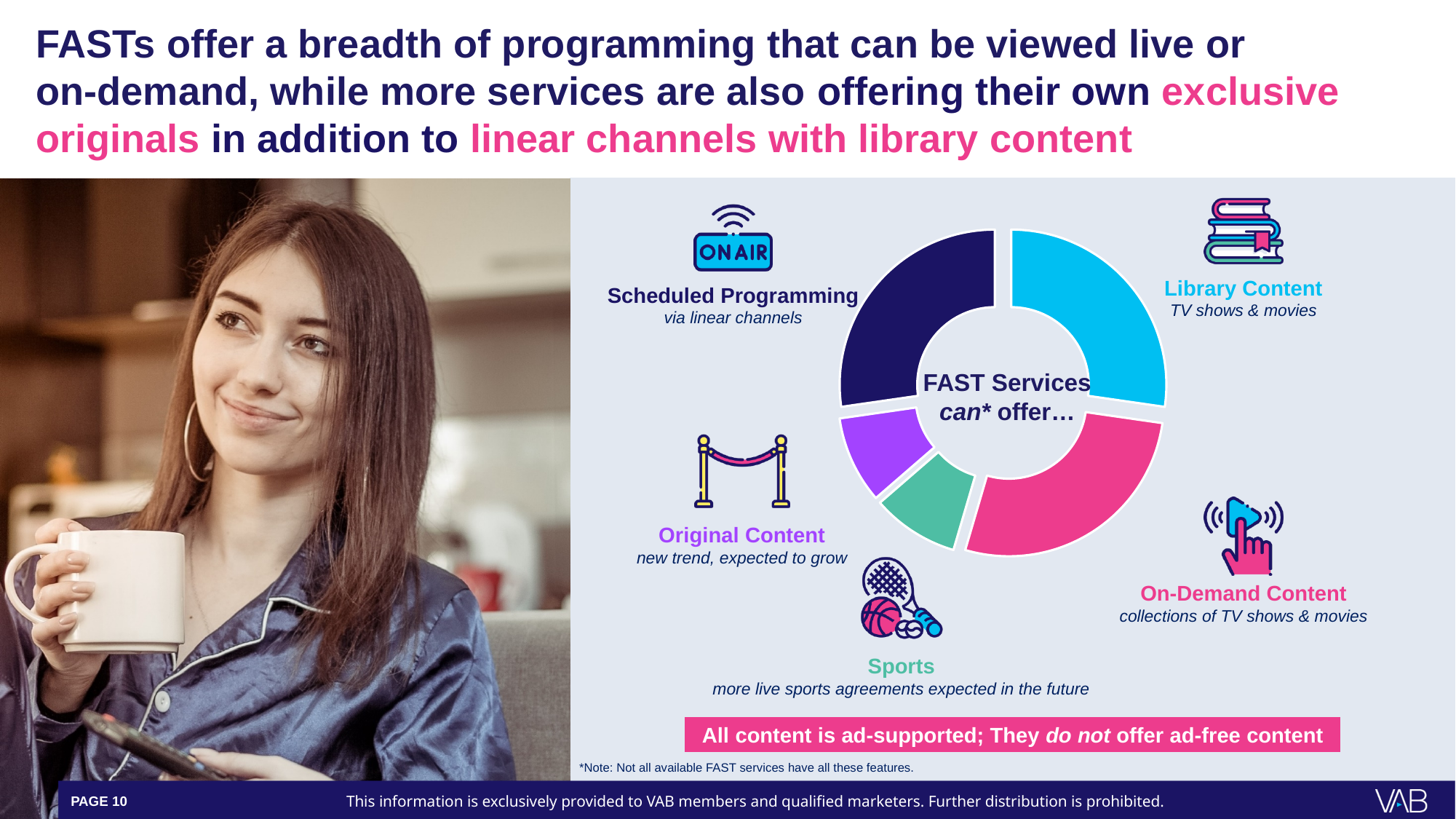
Which segment of the donut chart is described as 'via linear channels'? Scheduled Programming How many segments does the donut chart have? 5 Which segment of the donut chart is described as 'collections of TV shows & movies'? On-Demand Content Which segment of the donut chart is larger: Scheduled Programming or Original Content? Scheduled Programming What text appears in the center of the donut chart? FAST Services can* offer… Which segment of the donut chart is described as 'new trend, expected to grow'? Original Content Which segment of the donut chart is described as 'more live sports agreements expected in the future'? Sports What kind of chart is shown on the slide? Donut (pie) chart Which segment of the donut chart is larger: Library Content or Sports? Library Content Which segment of the donut chart is larger: On-Demand Content or Sports? On-Demand Content What colour is the Original Content segment of the donut chart? Purple